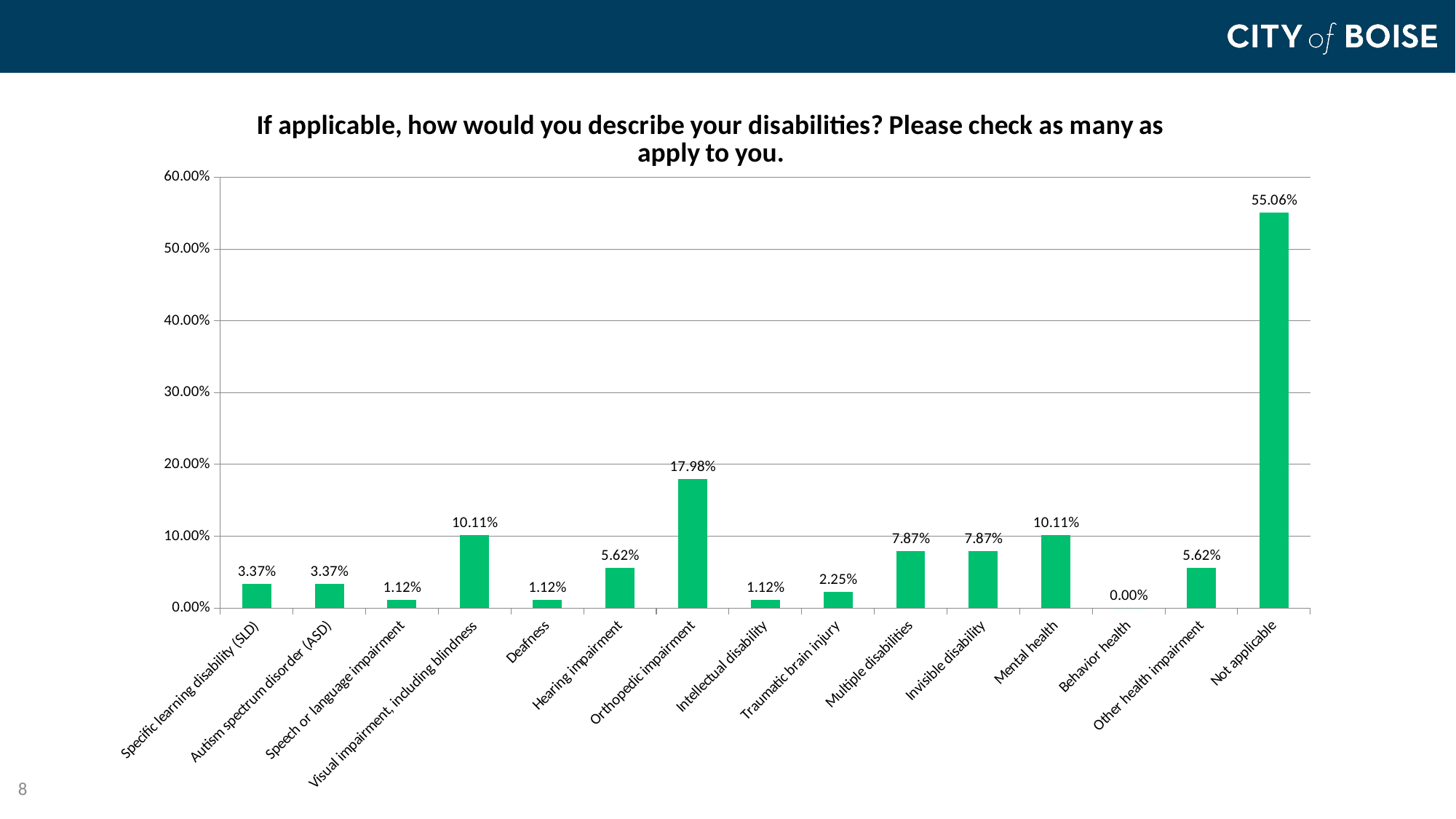
What kind of chart is this? Bar chart What is the value for Not applicable? 55.06% Which is larger, Hearing impairment or Multiple disabilities? Multiple disabilities What is the value for Traumatic brain injury? 2.25% Which category has the lowest value? Behavior health What is the title of the chart? If applicable, how would you describe your disabilities? Please check as many as apply to you. Is the value for Orthopedic impairment greater or less than 20.00%? less Which category has the highest value? Not applicable What is the value for Behavior health? 0.00% How many categories are shown on the x axis? 15 What is the value for Orthopedic impairment? 17.98% What is the difference between Not applicable and Orthopedic impairment? 37.08%